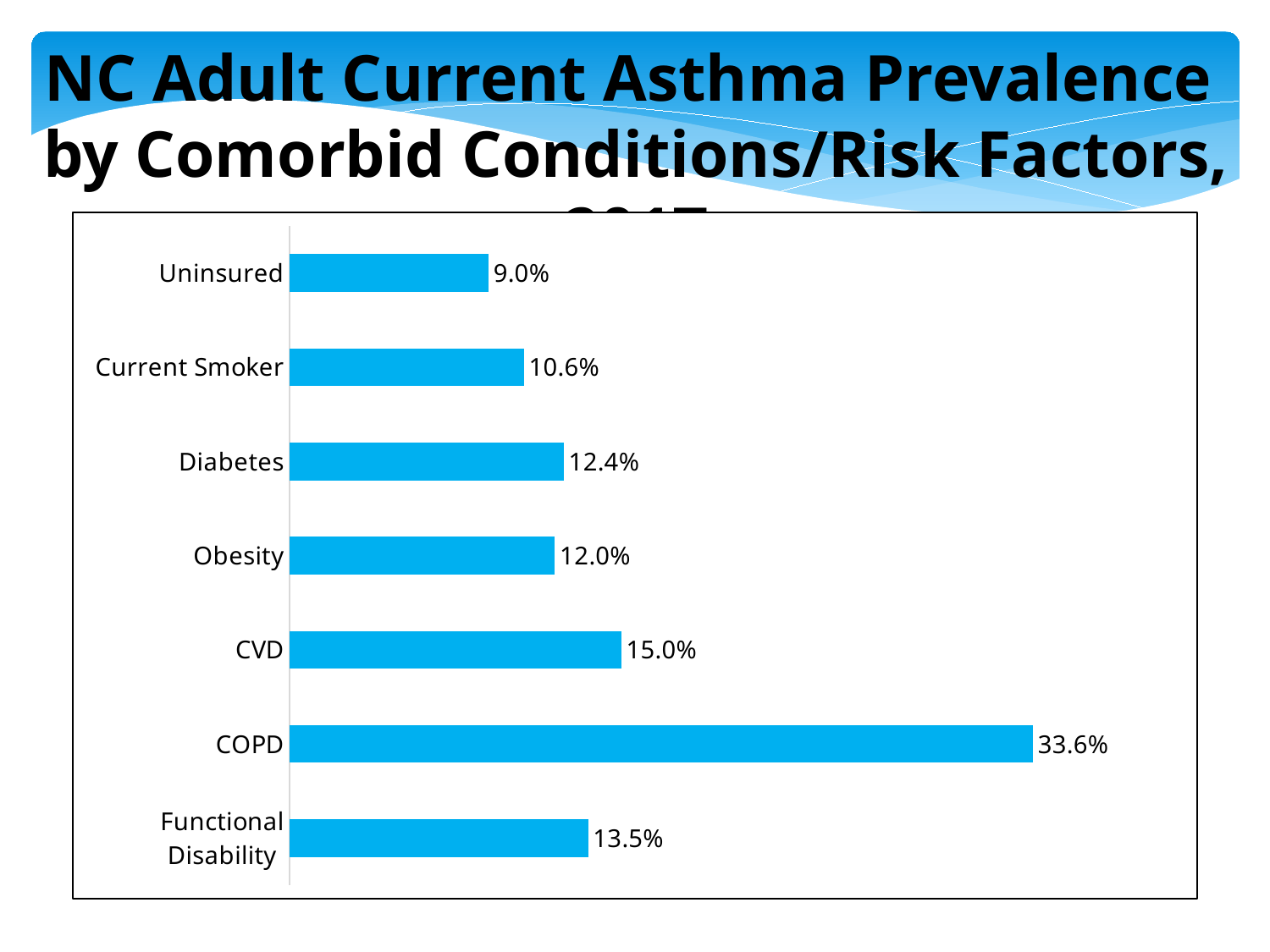
What is the asthma prevalence for adults with COPD? 33.6% Which has a higher asthma prevalence, Current Smoker or Uninsured? Current Smoker What is the asthma prevalence for Current Smokers? 10.6% What type of chart is shown on the slide? Bar chart How many comorbid conditions/risk factors are shown in the chart? 7 Which has a higher asthma prevalence, CVD or Functional Disability? CVD What is the asthma prevalence for adults with Functional Disability? 13.5% Which comorbid condition/risk factor has the highest asthma prevalence? COPD What is the difference in asthma prevalence between COPD and CVD? 18.6% What is the asthma prevalence for Uninsured adults? 9.0% Which comorbid condition/risk factor has the lowest asthma prevalence? Uninsured What is the difference in asthma prevalence between Diabetes and Obesity? 0.4%